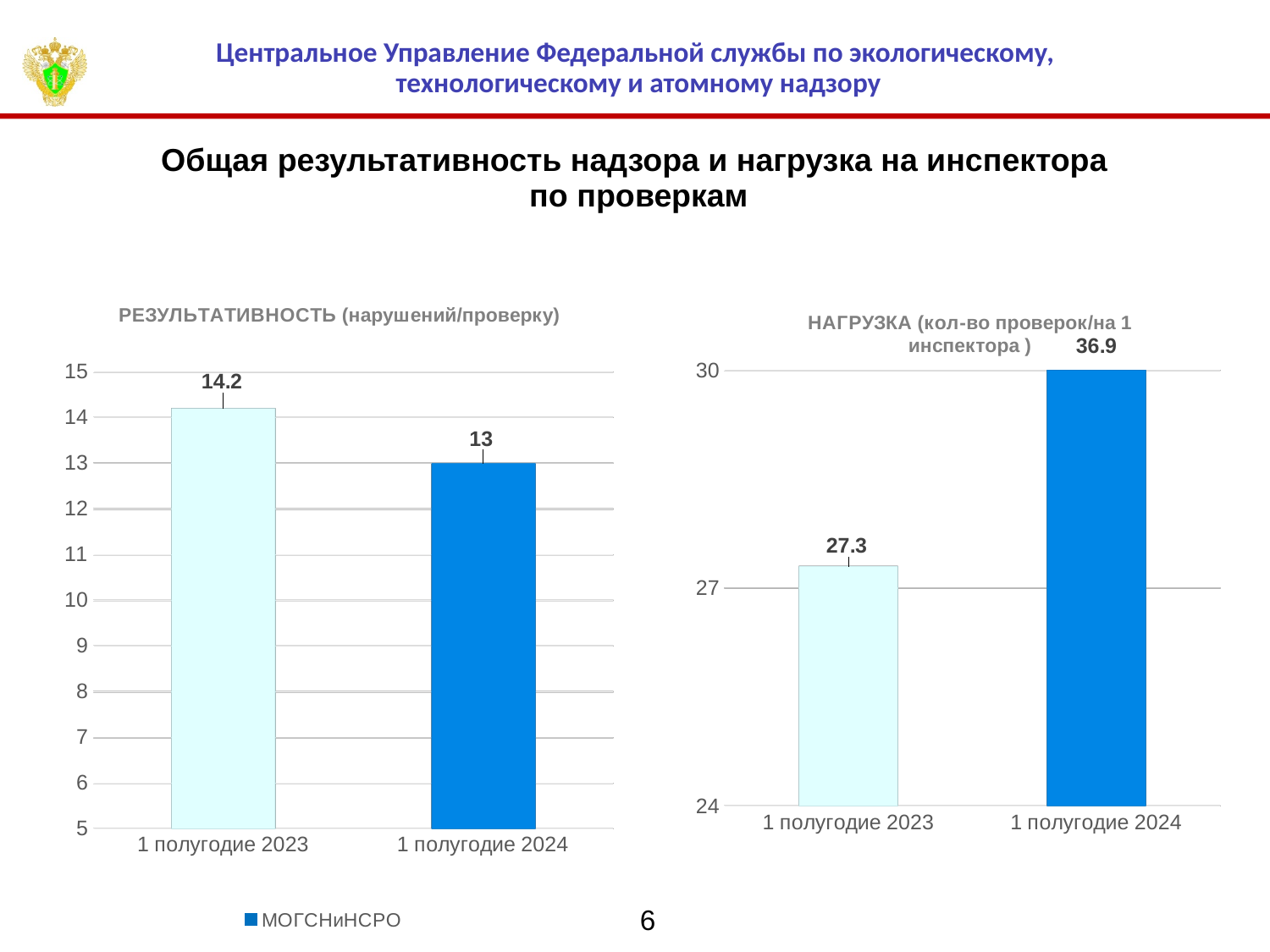
In the НАГРУЗКА (кол-во проверок/на 1 инспектора) chart, is the value for 1 полугодие 2024 greater or less than 30? greater In the НАГРУЗКА (кол-во проверок/на 1 инспектора) chart, which period has the lower value? 1 полугодие 2023 In the РЕЗУЛЬТАТИВНОСТЬ (нарушений/проверку) chart, what is the value for 1 полугодие 2023? 14.2 In the НАГРУЗКА (кол-во проверок/на 1 инспектора) chart, by how much does the value for 1 полугодие 2024 exceed the value for 1 полугодие 2023? 9.6 What kind of chart is the НАГРУЗКА (кол-во проверок/на 1 инспектора) chart? bar chart In the НАГРУЗКА (кол-во проверок/на 1 инспектора) chart, what is the value for 1 полугодие 2024? 36.9 In the РЕЗУЛЬТАТИВНОСТЬ (нарушений/проверку) chart, what is the value for 1 полугодие 2024? 13 In the РЕЗУЛЬТАТИВНОСТЬ (нарушений/проверку) chart, do the values rise or fall from 1 полугодие 2023 to 1 полугодие 2024? fall In the РЕЗУЛЬТАТИВНОСТЬ (нарушений/проверку) chart, what is the difference between the values for 1 полугодие 2023 and 1 полугодие 2024? 1.2 In the НАГРУЗКА (кол-во проверок/на 1 инспектора) chart, what is the value for 1 полугодие 2023? 27.3 How many categories are shown on the x axis of the РЕЗУЛЬТАТИВНОСТЬ (нарушений/проверку) chart? 2 In the РЕЗУЛЬТАТИВНОСТЬ (нарушений/проверку) chart, which period has the higher value? 1 полугодие 2023